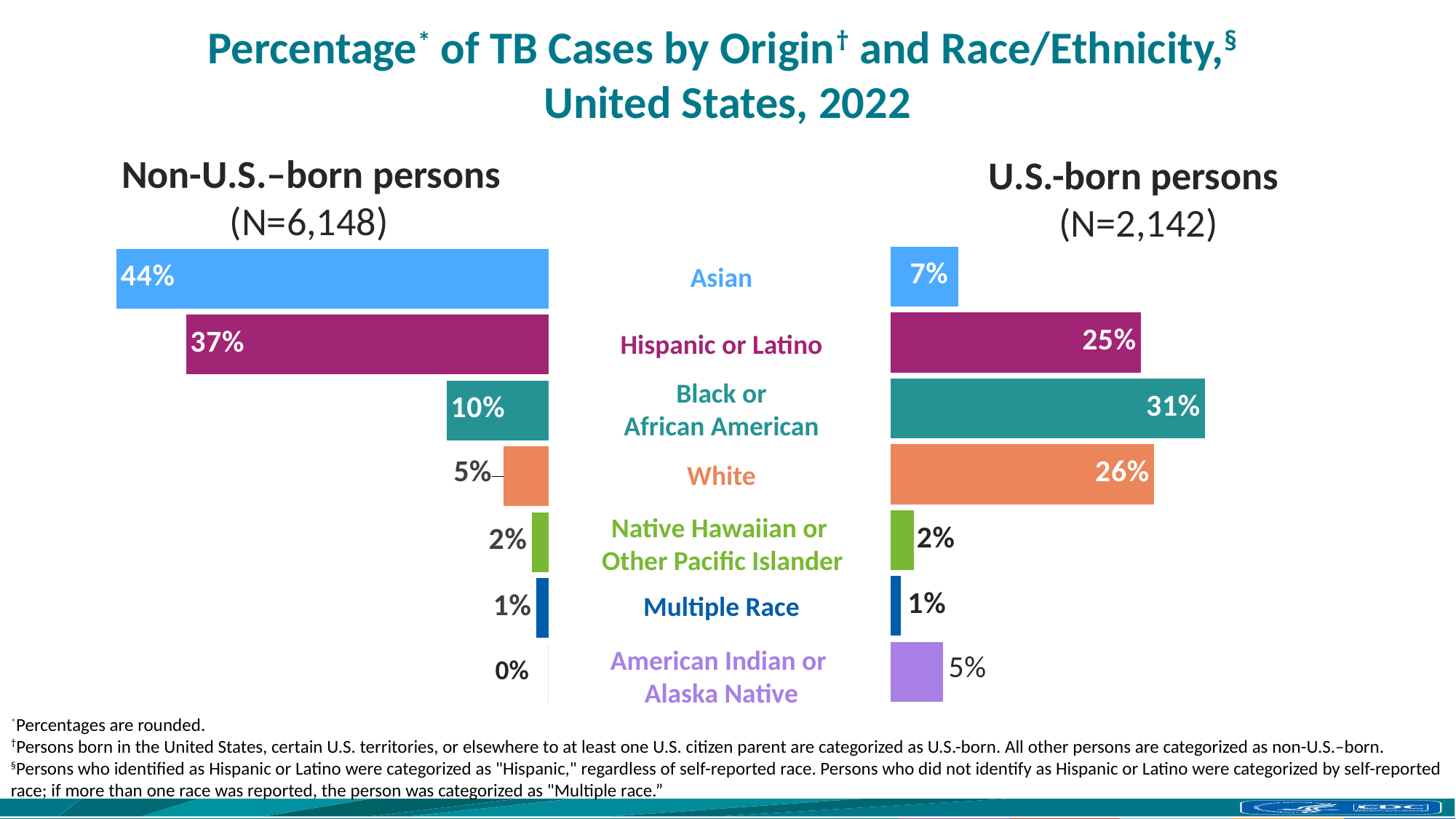
In the U.S.-born persons chart, which race/ethnicity category has the highest percentage? Black or African American In the Non-U.S.-born persons chart, what percentage of TB cases is for Asian persons? 44% In the Non-U.S.-born persons chart, which race/ethnicity category has the highest percentage? Asian In the Non-U.S.-born persons chart, what is the difference between the Asian and Hispanic or Latino percentages? 7% In the U.S.-born persons chart, what is the difference between the White and Hispanic or Latino percentages? 1% In the U.S.-born persons chart, what percentage of TB cases is for Black or African American persons? 31% Is the percentage for Hispanic or Latino persons larger in the Non-U.S.-born persons chart or the U.S.-born persons chart? Non-U.S.-born persons How many race/ethnicity categories are shown in the Non-U.S.-born persons chart? 7 In the U.S.-born persons chart, what percentage of TB cases is for American Indian or Alaska Native persons? 5% What is the N value shown for the U.S.-born persons chart? N=2,142 What kind of chart is used to show the percentages for U.S.-born persons? Bar chart In the Non-U.S.-born persons chart, which race/ethnicity category has the lowest percentage? American Indian or Alaska Native